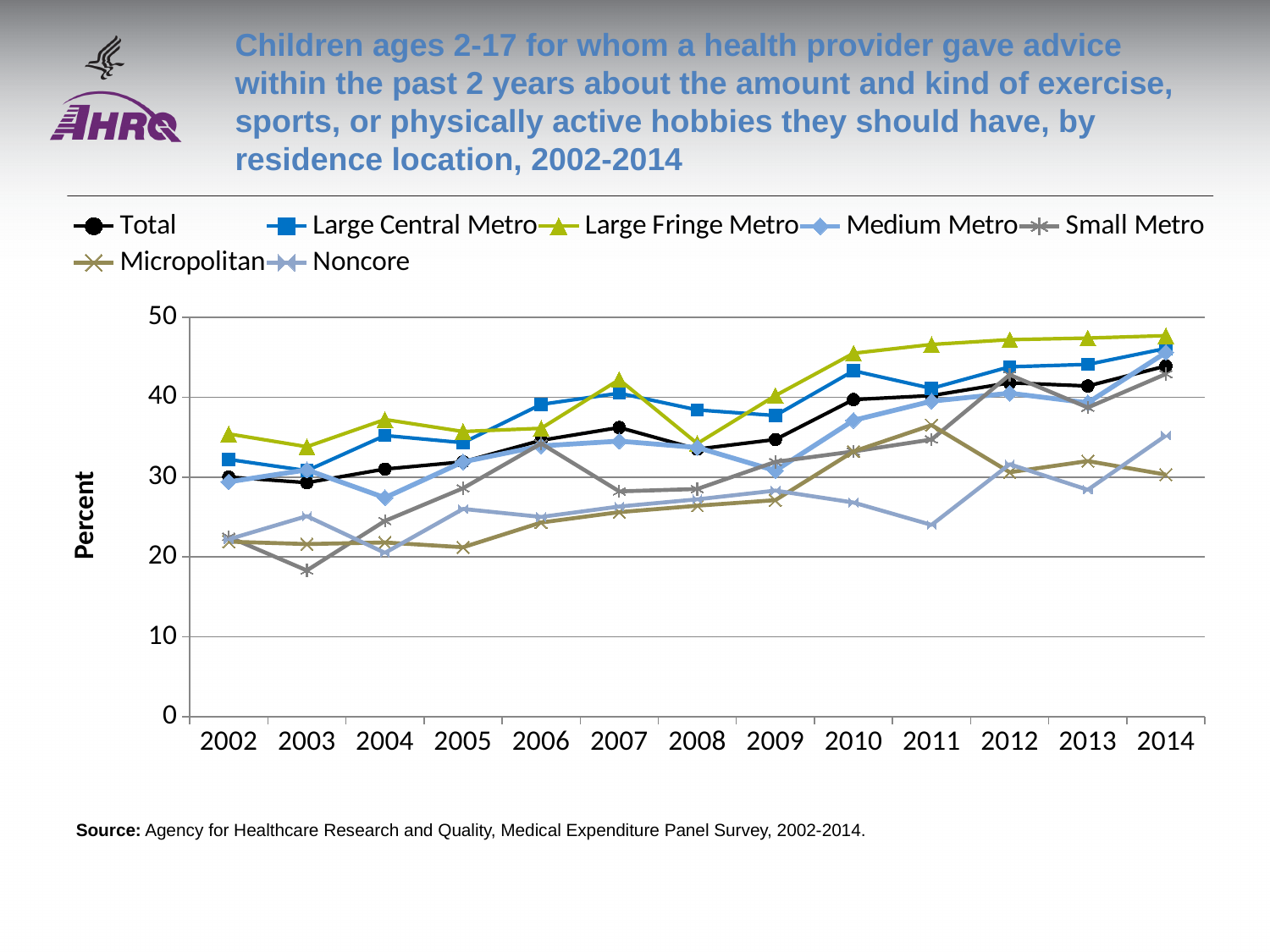
Which residence location has the highest value in 2014? Large Fringe Metro In 2010, which is larger: Large Central Metro or Total? Large Central Metro Which residence location has the lowest value in 2003? Small Metro Is the value for Noncore in 2011 greater or less than 30? less Is the value for Total in 2014 greater or less than 40? greater How many series does the legend list? 7 Is the value for Small Metro in 2003 greater or less than 20? less How many years are plotted along the x axis? 13 Does the Large Fringe Metro line rise or fall from 2010 to 2014? rise What kind of chart is shown on the slide? Line chart What is the label on the y axis? Percent Which residence location has the lowest value in 2014? Micropolitan